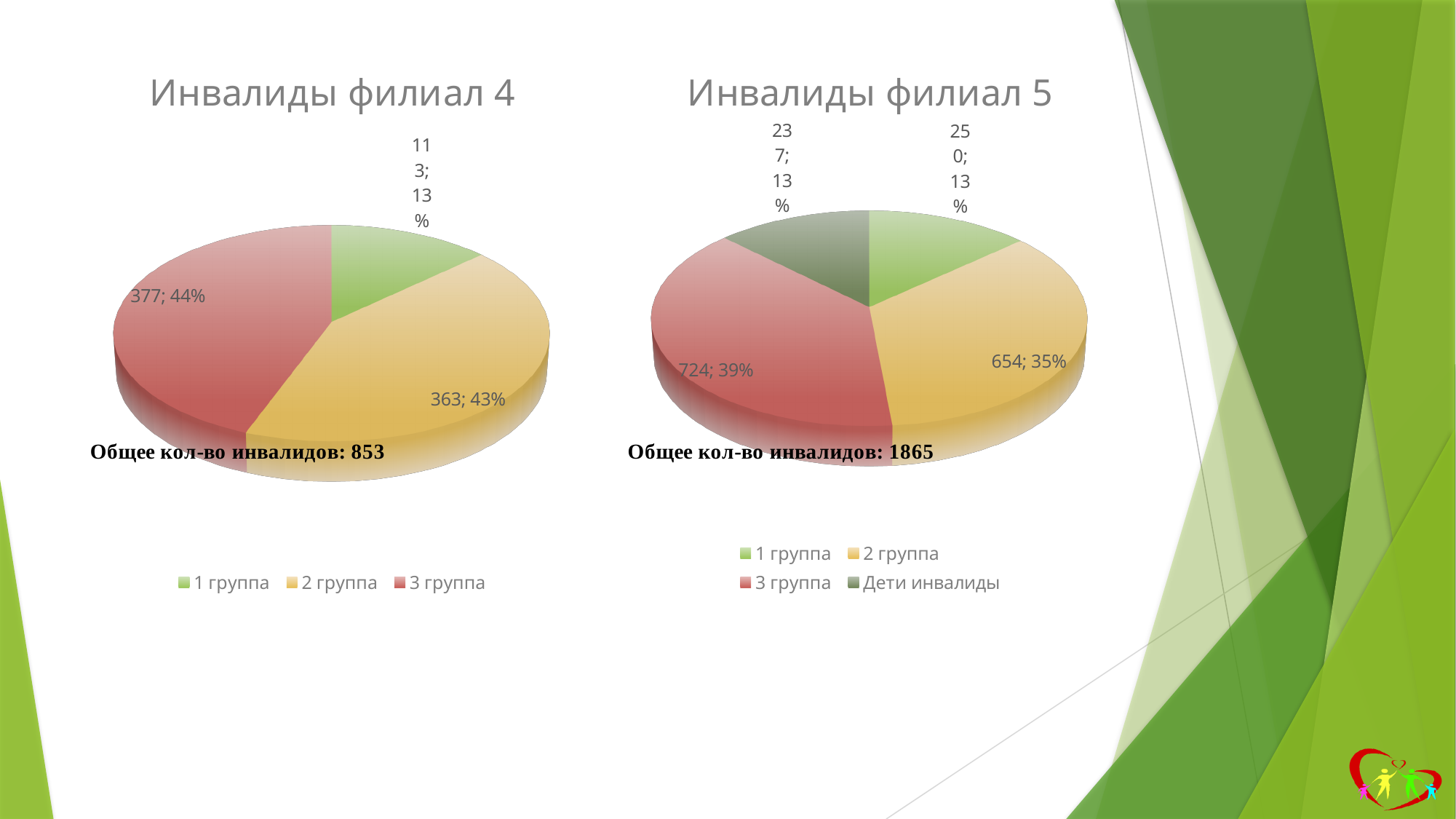
In the chart titled "Инвалиды филиал 5", what value is shown for 2 группа? 654; 35% In the chart titled "Инвалиды филиал 4", which category has the smallest slice? 1 группа In the chart titled "Инвалиды филиал 4", what is the difference between the values for 3 группа and 2 группа? 14 In the chart titled "Инвалиды филиал 4", what value is shown for 2 группа? 363; 43% In the chart titled "Инвалиды филиал 5", what colour is the slice for Дети инвалиды? Dark green In the chart titled "Инвалиды филиал 5", what value is shown for 3 группа? 724; 39% In the chart titled "Инвалиды филиал 4", what share of the pie does 1 группа have? 13% In the chart titled "Инвалиды филиал 5", which is larger, 3 группа or 2 группа? 3 группа In the chart titled "Инвалиды филиал 5", which category has the largest slice? 3 группа In the chart titled "Инвалиды филиал 4", what value is shown for 3 группа? 377; 44% What kind of chart is "Инвалиды филиал 4"? Pie chart In the chart titled "Инвалиды филиал 5", how many categories does the legend list? 4